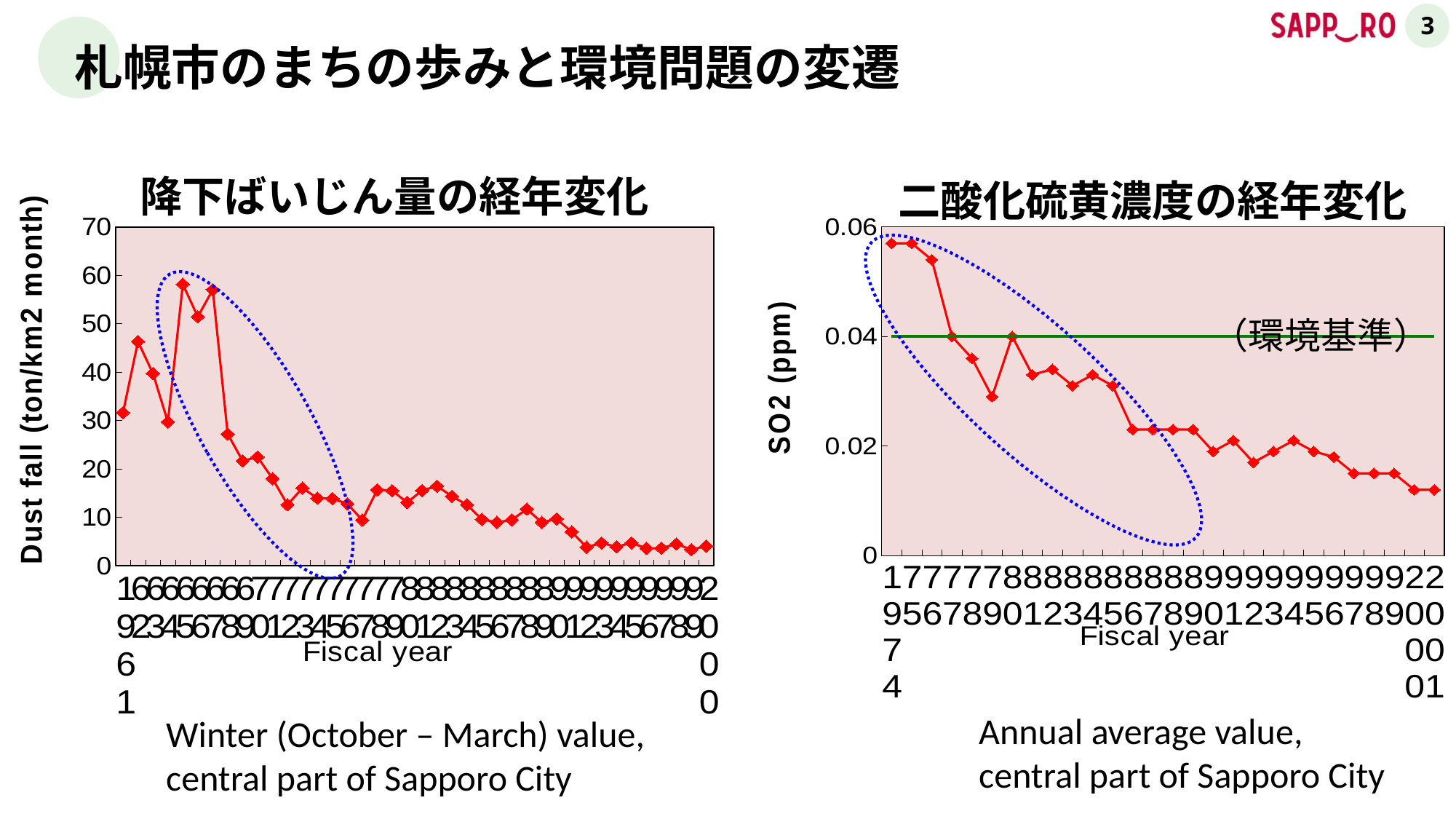
What type of chart is the 降下ばいじん量の経年変化 chart on the left? Line chart In the 降下ばいじん量の経年変化 chart, is the value for fiscal year 1961 greater or less than 20? greater What is the y-axis label of the 降下ばいじん量の経年変化 chart? Dust fall (ton/km2 month) In the 降下ばいじん量の経年変化 chart, which is larger: the value for fiscal year 1961 or the value for fiscal year 2000? 1961 What type of chart is the 二酸化硫黄濃度の経年変化 chart on the right? Line chart In the 二酸化硫黄濃度の経年変化 chart, is the value for fiscal year 2001 greater or less than 0.02? less In the 二酸化硫黄濃度の経年変化 chart, is the value for fiscal year 1974 greater or less than 0.04? greater In the 降下ばいじん量の経年変化 chart, do the values overall rise or fall from the earliest to the latest fiscal year? Fall In the 二酸化硫黄濃度の経年変化 chart, what SO2 value does the green horizontal line labelled (環境基準) mark? 0.04 What is the y-axis label of the 二酸化硫黄濃度の経年変化 chart? SO2 (ppm) In the 二酸化硫黄濃度の経年変化 chart, do the SO2 values overall rise or fall across the fiscal years? Fall